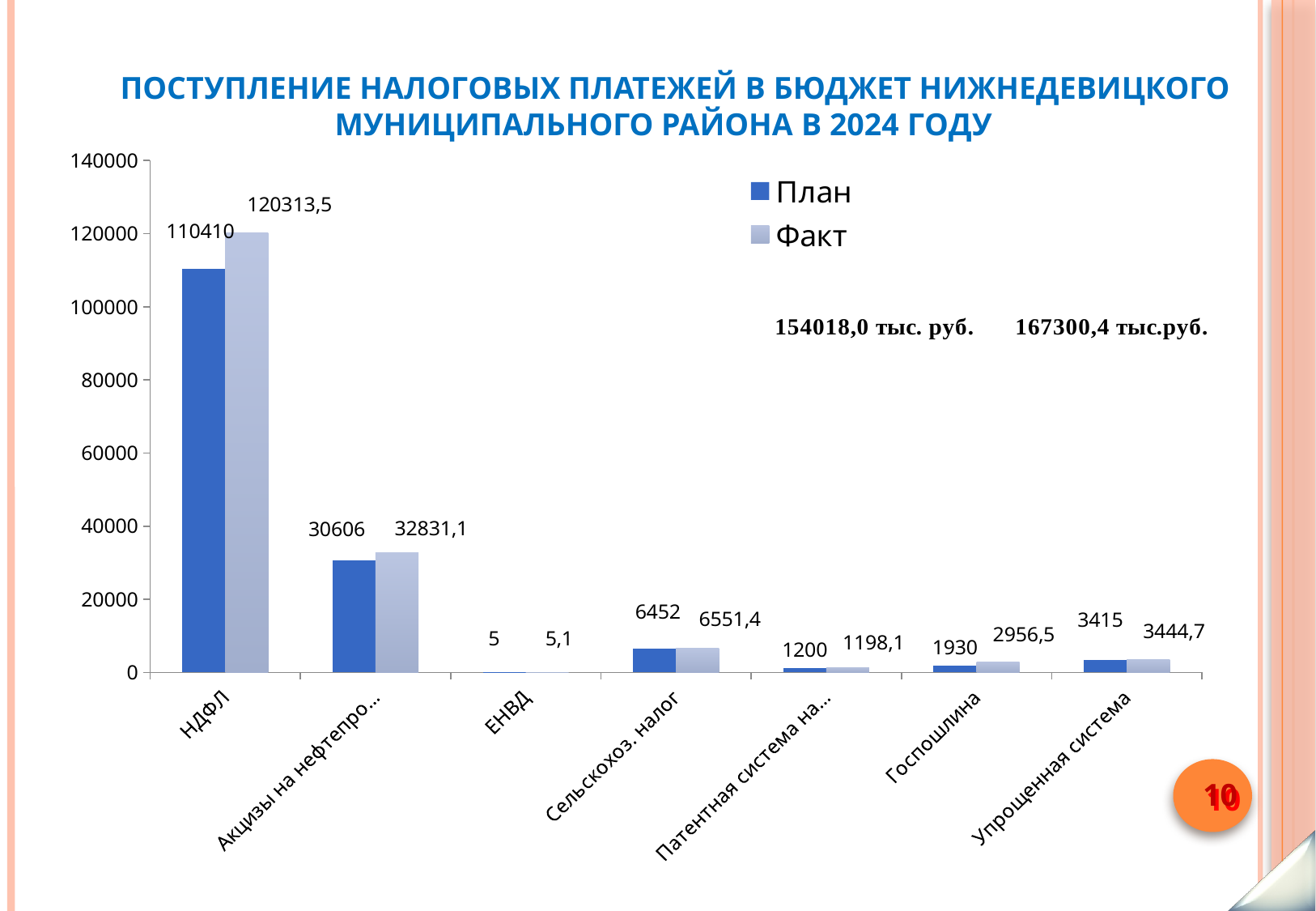
What is the План value for НДФЛ? 110410 How many series does the legend list? 2 What is the difference between the Факт and План values for Госпошлина? 1026,5 What is the План value for Сельскохоз. налог? 6452 Which category has the lowest План value? ЕНВД Which category has the highest Факт value? НДФЛ What are the two legend entries of the chart? План and Факт How many categories are shown on the x axis? 7 What is the Факт value for Госпошлина? 2956,5 What is the Факт value for НДФЛ? 120313,5 What type of chart is shown on the slide? bar chart For Патентная система, which is larger: the План value or the Факт value? План